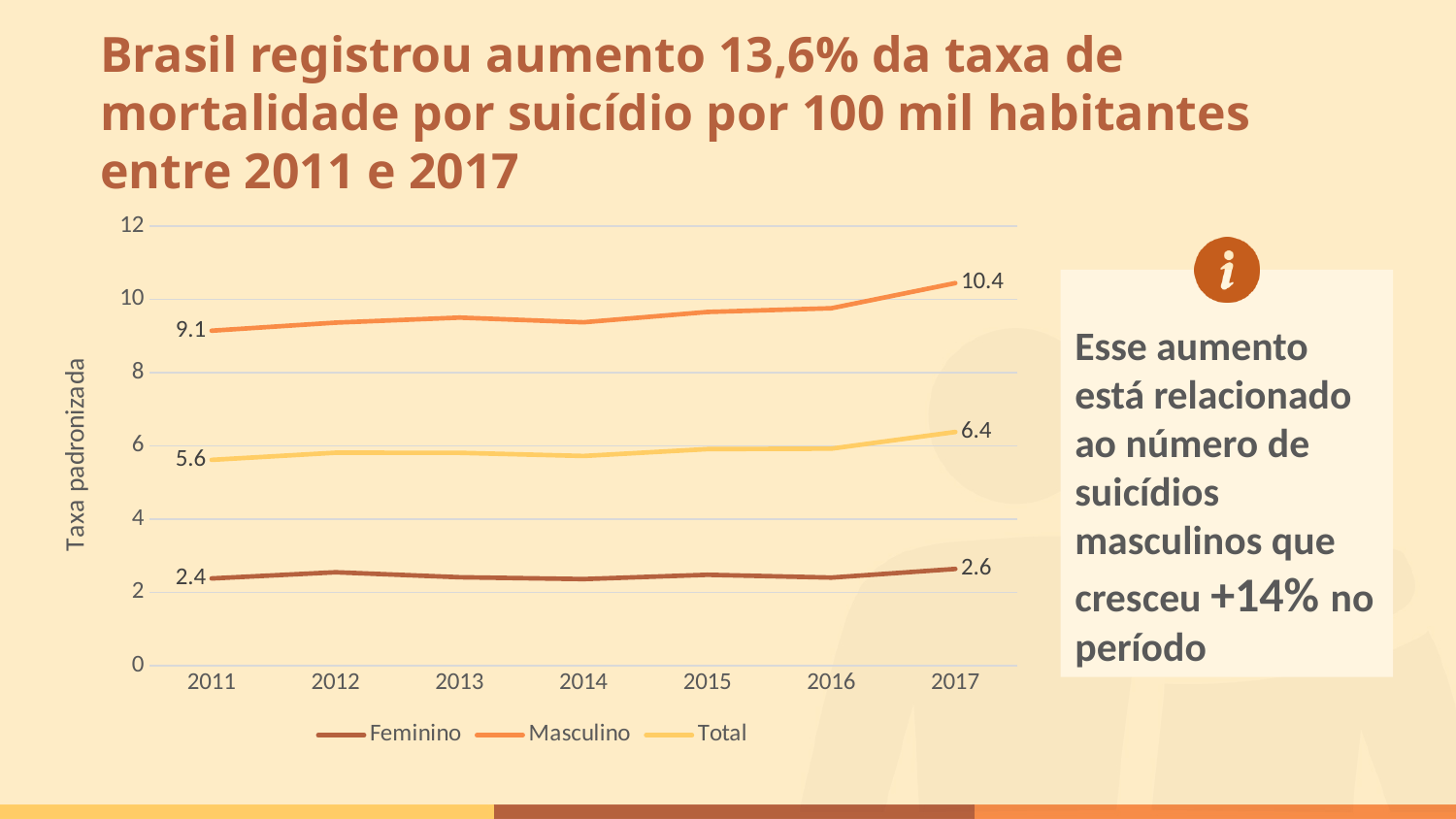
By how much did the Masculino value increase from 2011 to 2017? 1.3 What is the value for Feminino in 2011? 2.4 How many series does the legend list? 3 What is the value for Total in 2017? 6.4 What is the difference between the Masculino and Feminino values in 2017? 7.8 What is the value for Masculino in 2011? 9.1 What type of chart is shown on the slide? line chart What is the value for Masculino in 2017? 10.4 Is the value for Total in 2014 greater or less than 6? less What is the label of the y axis? Taxa padronizada Which series has the highest values across the chart? Masculino How many years are shown on the x axis? 7